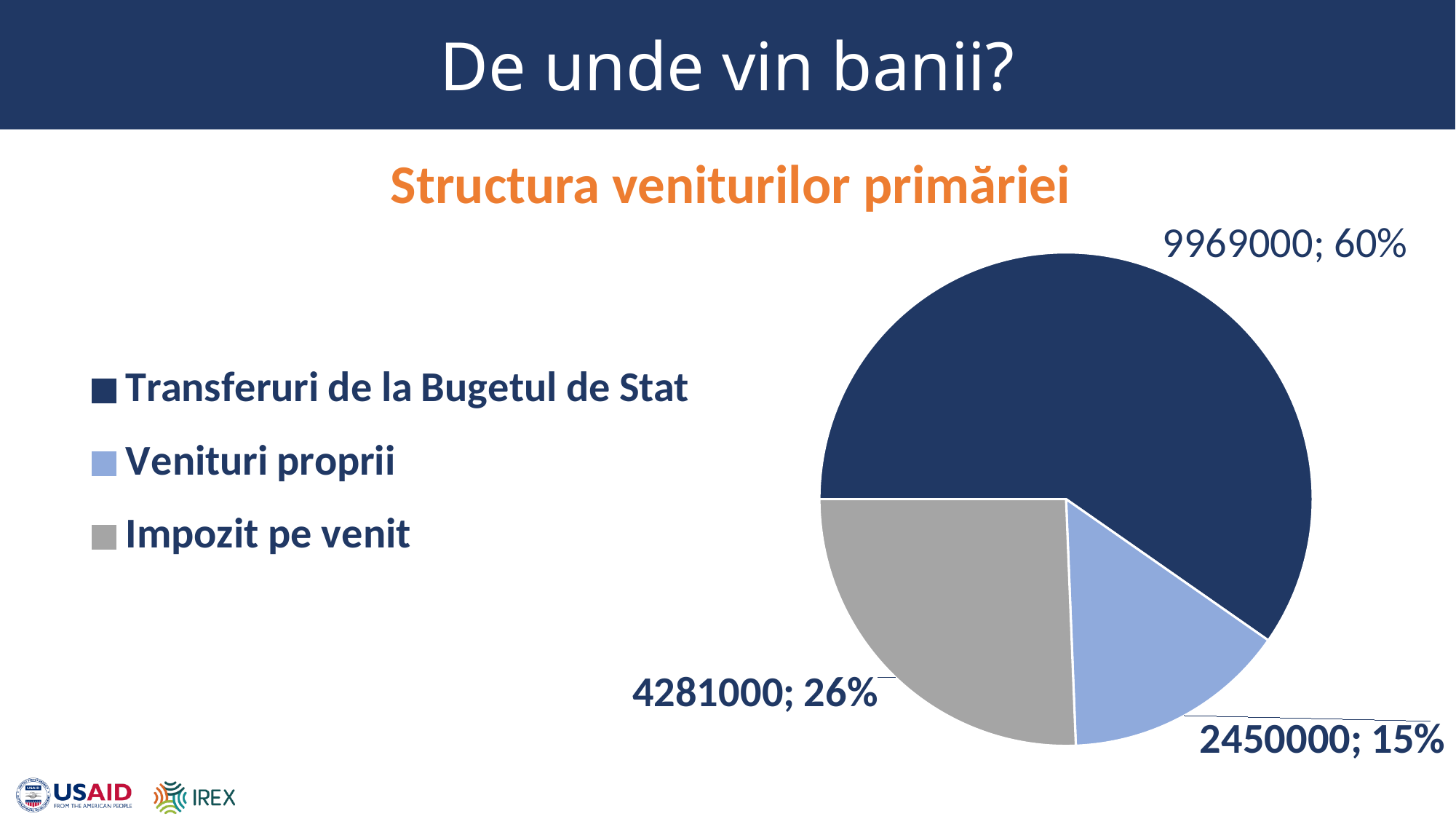
What is the value for Impozit pe venit? 4281000 How many categories does the pie chart have? 3 What is the difference between the values for Impozit pe venit and Venituri proprii? 1831000 Which category has the largest slice? Transferuri de la Bugetul de Stat What is the value for Venituri proprii? 2450000 Which is larger, Impozit pe venit or Venituri proprii? Impozit pe venit What is the value for Transferuri de la Bugetul de Stat? 9969000 What share of the pie does Transferuri de la Bugetul de Stat represent? 60% What kind of chart is shown on the slide? pie chart What is the title of the chart? Structura veniturilor primăriei What share of the pie does Impozit pe venit represent? 26% Which category has the smallest slice? Venituri proprii